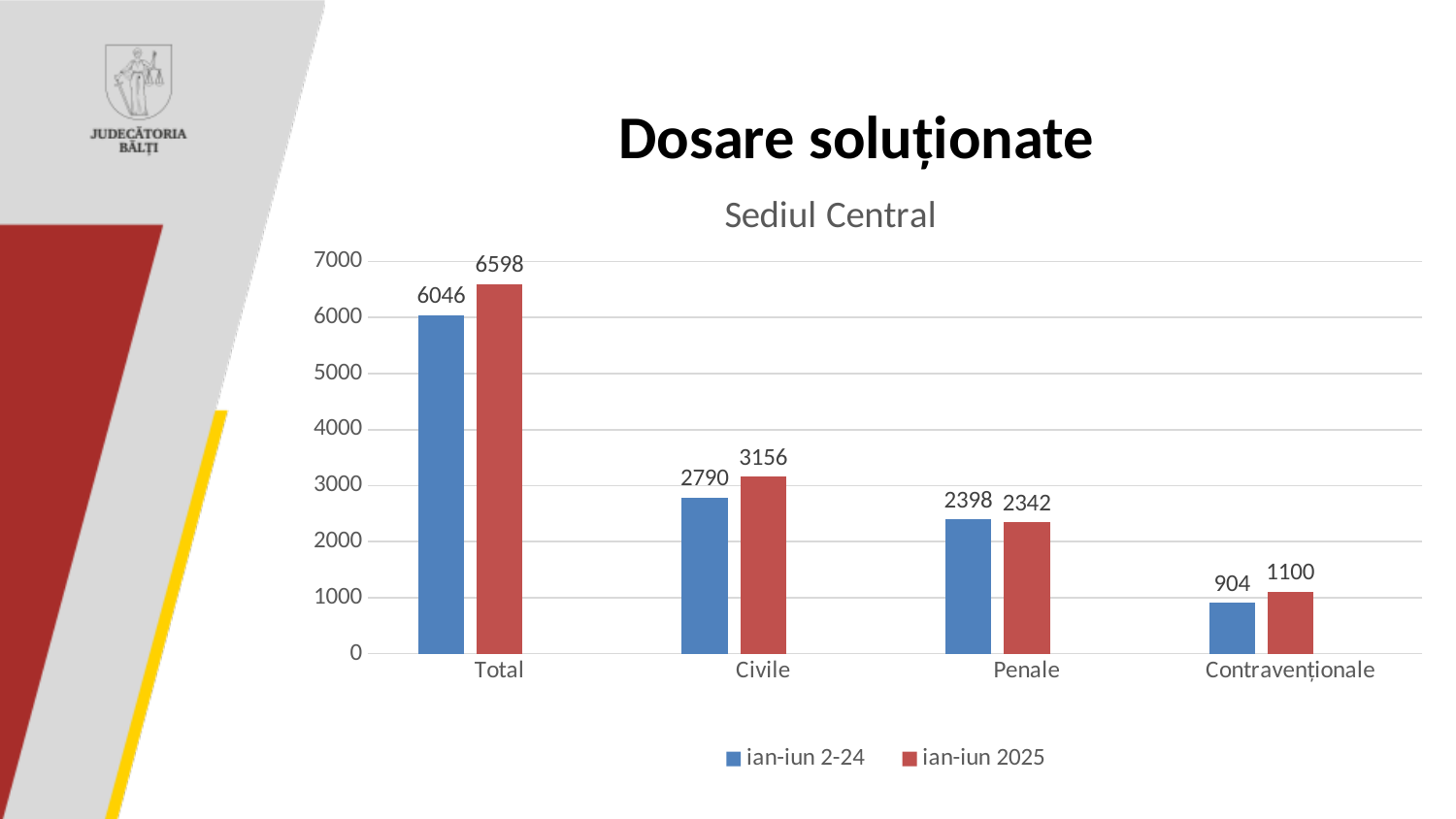
What is the difference between the ian-iun 2025 and ian-iun 2-24 values for Civile? 366 Which is larger for Penale: the ian-iun 2-24 value or the ian-iun 2025 value? ian-iun 2-24 What kind of chart is shown on the slide? Bar chart What is the value for Contravenționale in the ian-iun 2025 series? 1100 What is the value for Total in the ian-iun 2025 series? 6598 What is the value for Civile in the ian-iun 2-24 series? 2790 Which category has the lowest value in the ian-iun 2-24 series? Contravenționale What is the title of the chart? Sediul Central Which category has the highest value in the ian-iun 2025 series? Total How many series does the legend list? 2 What is the difference between the ian-iun 2025 and ian-iun 2-24 values for Total? 552 How many categories are shown on the x axis? 4